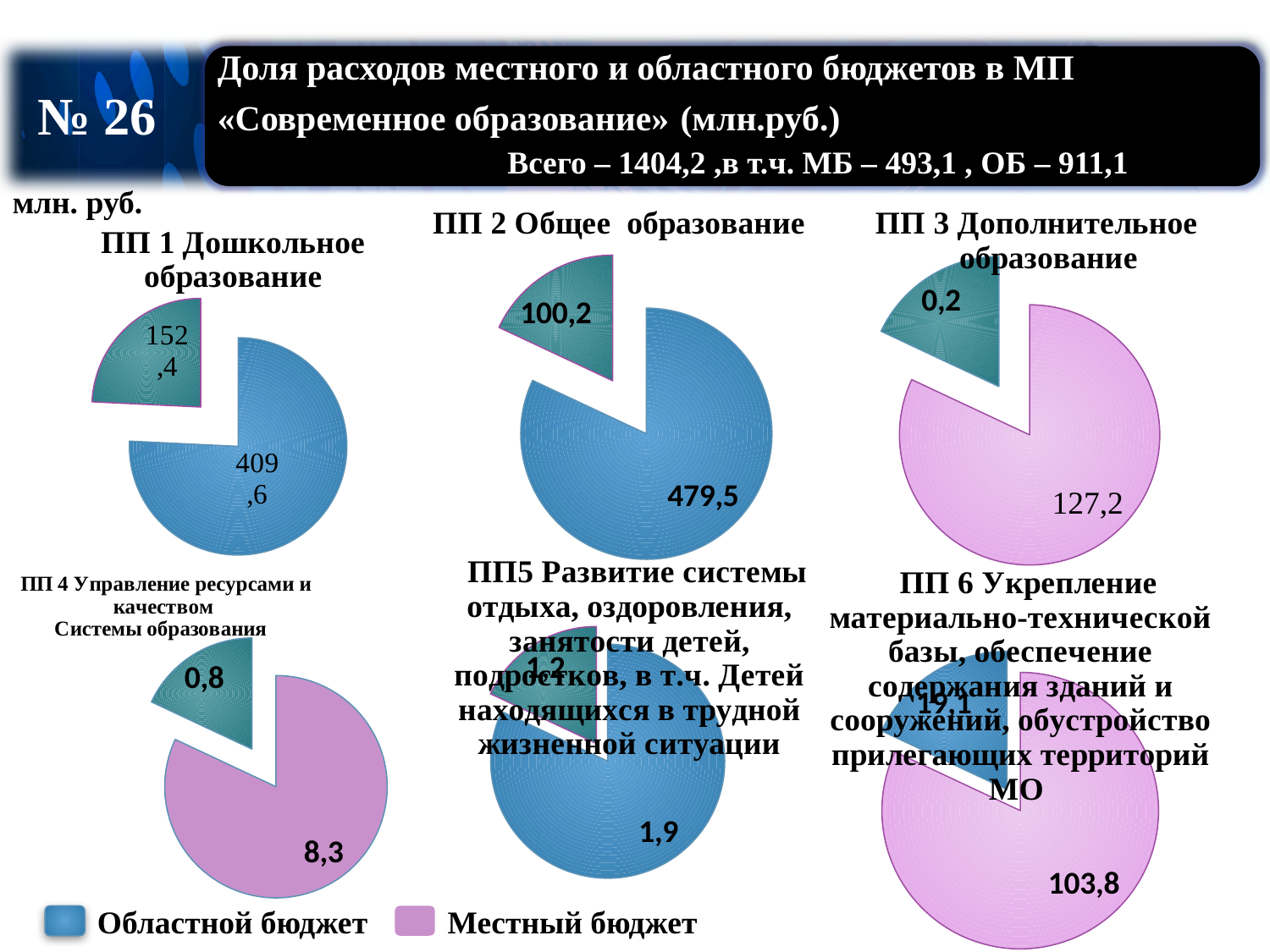
In the ПП 1 Дошкольное образование chart, what is the total of the two slices? 562,0 In the ПП 4 Управление ресурсами и качеством chart, which slice is larger, 0,8 or 8,3? 8,3 In the ПП 4 Управление ресурсами и качеством chart, what is the value of the larger slice? 8,3 In the ПП 1 Дошкольное образование chart, what is the value of the larger slice? 409,6 In the ПП 3 Дополнительное образование chart, what is the value of the small exploded slice? 0,2 What kind of chart is used for ПП 3 Дополнительное образование? Pie chart In the ПП 2 Общее образование chart, what is the difference between the two slice values? 379,3 In the ПП 6 Укрепление материально-технической базы chart, what is the value of the larger slice? 103,8 How many slices does the ПП 5 Развитие системы отдыха chart have? 2 How many entries does the legend at the bottom of the slide list? 2 In the ПП 2 Общее образование chart, what is the value of the larger slice? 479,5 In the ПП 1 Дошкольное образование chart, what is the value of the smaller, exploded slice? 152,4